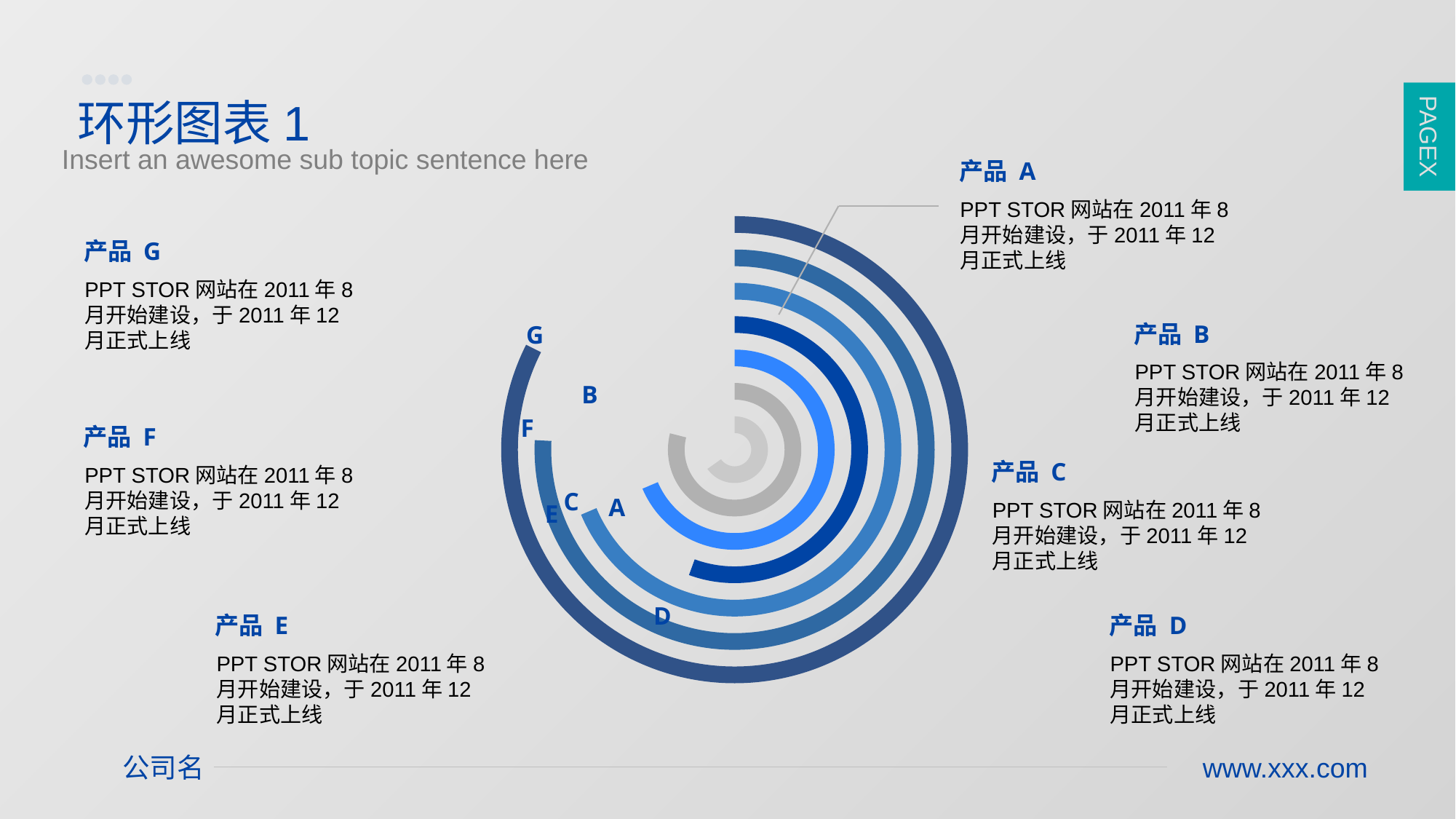
What kind of chart is shown on the slide? ring chart Which letter labels the outermost ring of the chart? G How many labeled products (categories) does the chart show? 7 Which product has the longest arc in the chart? G What is the title of the slide containing the chart? 环形图表 1